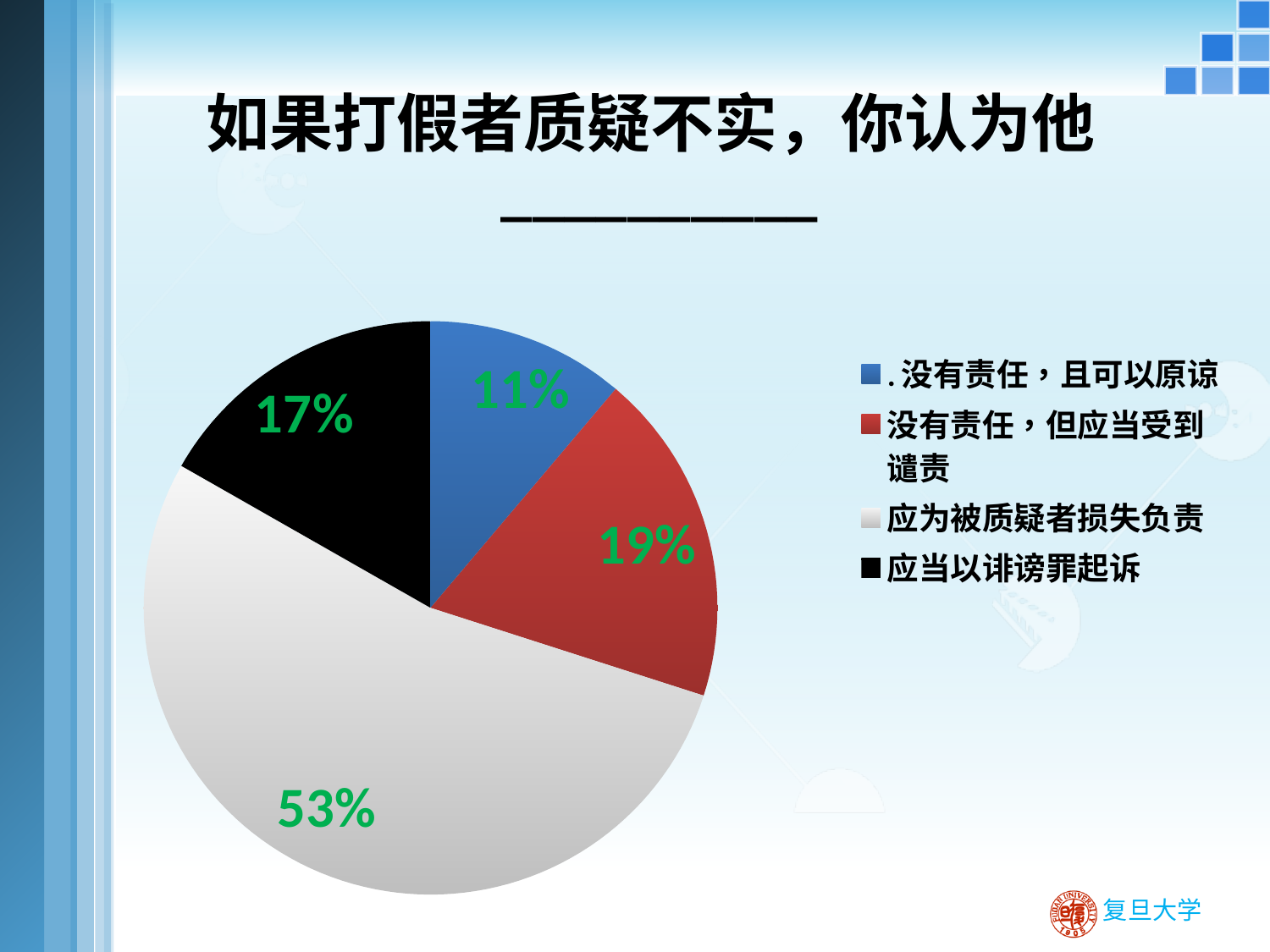
What percentage of the pie is the slice for 没有责任，且可以原谅? 11% What percentage of the pie is the slice for 没有责任，但应当受到谴责? 19% What kind of chart is shown on the slide? pie chart What colour is the slice for 应当以诽谤罪起诉? black What percentage of the pie is the slice for 应当以诽谤罪起诉? 17% What percentage of the pie is the slice for 应为被质疑者损失负责? 53% What colour is the slice for 没有责任，且可以原谅? blue Which slice is larger: 没有责任，但应当受到谴责 or 应当以诽谤罪起诉? 没有责任，但应当受到谴责 Which category has the smallest slice of the pie? 没有责任，且可以原谅 How many categories does the pie chart have? 4 What is the difference in percentage points between the slices for 应为被质疑者损失负责 and 没有责任，但应当受到谴责? 34 Which category has the largest slice of the pie? 应为被质疑者损失负责